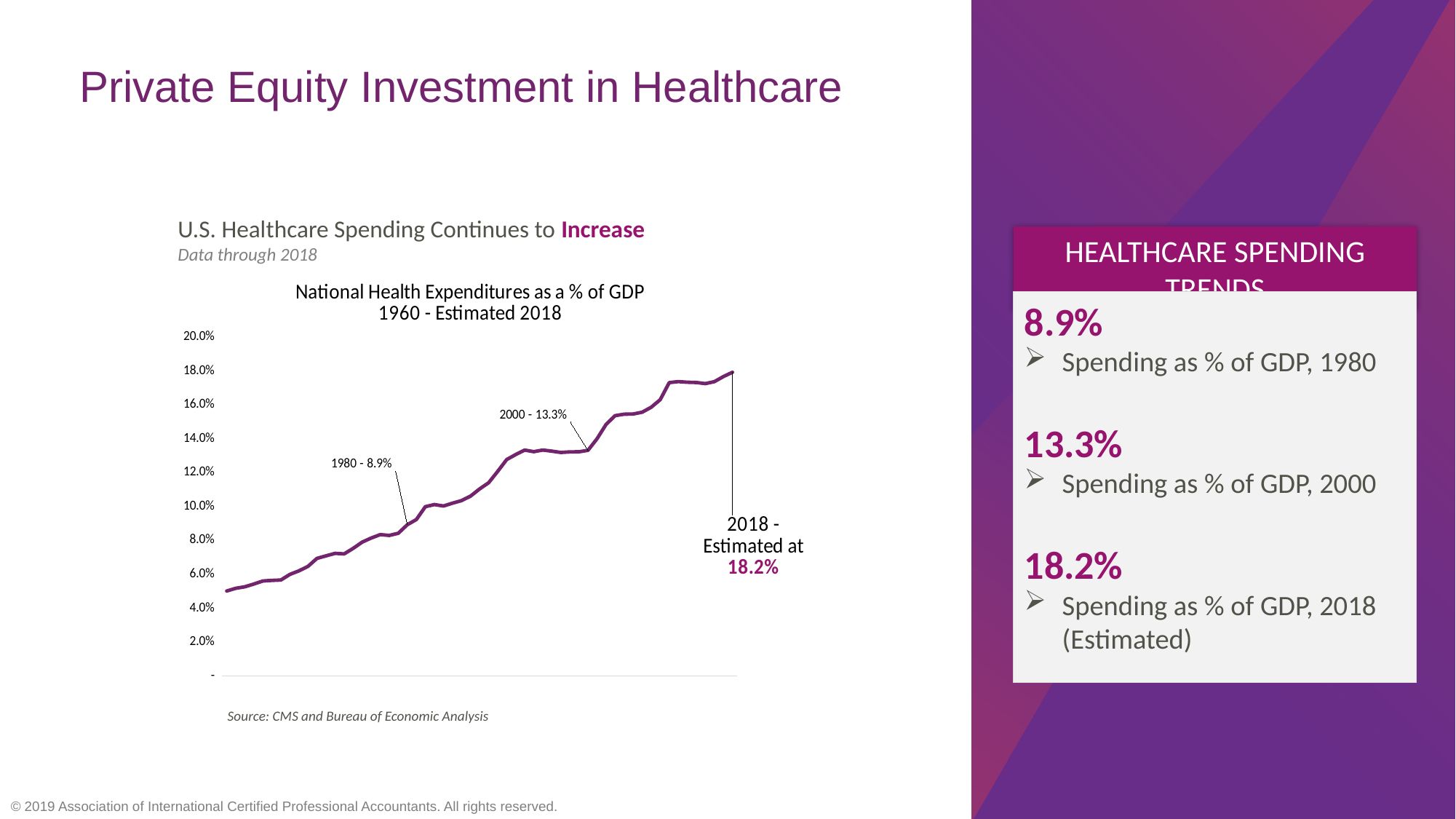
What is the highest tick value shown on the chart's vertical axis? 20.0% Which year has the larger labeled value, 1980 or 2000? 2000 How much higher is the 2018 estimated value than the 1980 value? 9.3 percentage points What is the difference between the 2018 estimate and the 2000 value on the chart? 4.9 percentage points What value does the chart label for the year 2000? 13.3% Do the values on the chart generally rise or fall from 1960 to 2018? Rise What was national health expenditure as a % of GDP in 1980, according to the chart? 8.9% What is the estimated national health expenditure as a % of GDP for 2018 shown on the chart? 18.2% By how many percentage points did the labeled value rise from 1980 to 2000? 4.4 percentage points Of the three labeled years on the chart, which has the highest value? 2018 What type of chart is used to show National Health Expenditures as a % of GDP? Line chart Is the value at the start of the line (1960) greater or less than 6.0%? less